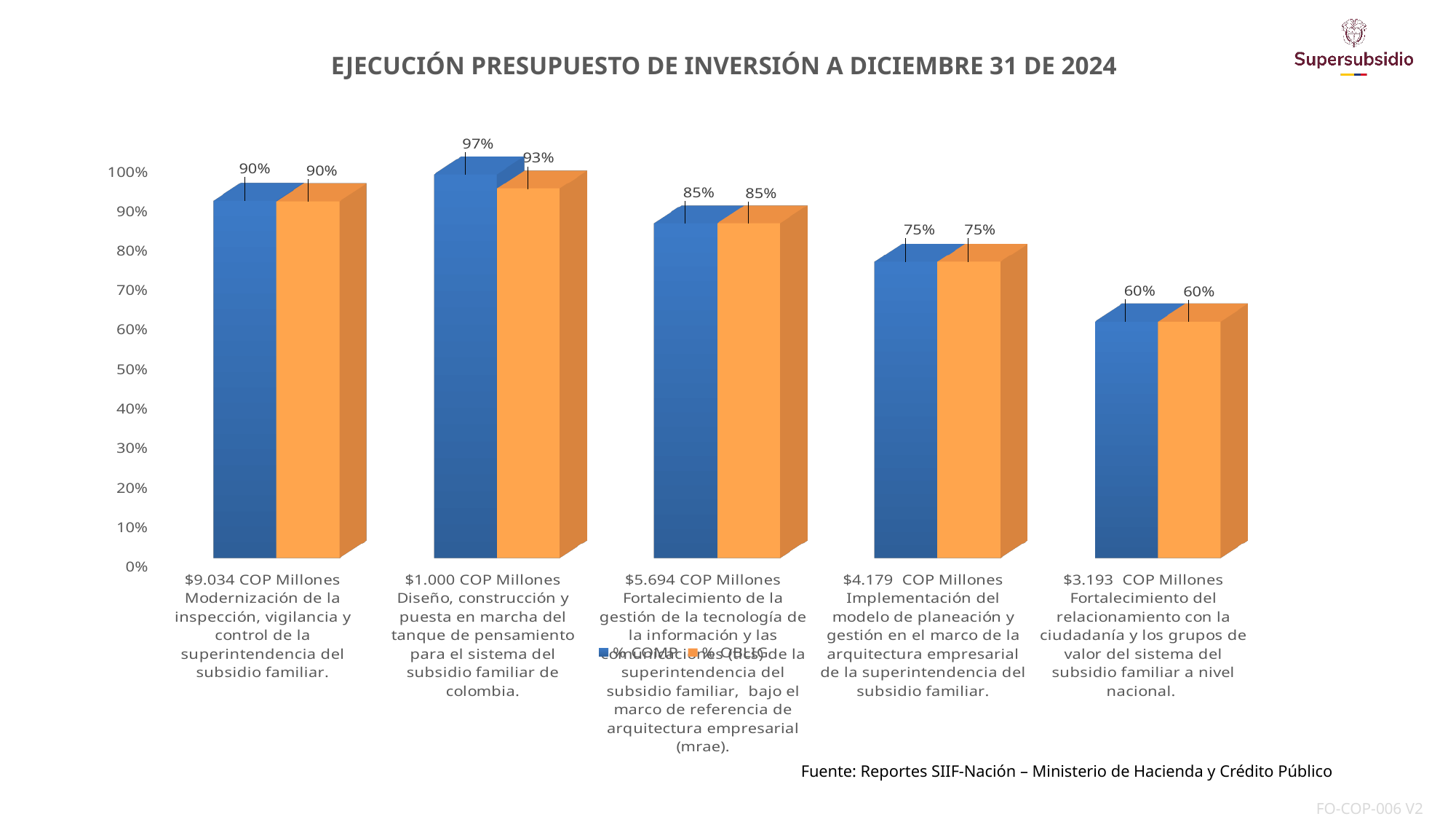
How many series does the legend list? 2 What is the difference between the % COMP and % OBLIG values for the $1.000 COP Millones project? 4% How many projects (categories) are shown on the chart? 5 What kind of chart is shown on the slide? Bar chart Which is larger: the % COMP value for the $9.034 COP Millones project or the % COMP value for the $4.179 COP Millones project? $9.034 COP Millones project What is the % OBLIG value for the $5.694 COP Millones project (Fortalecimiento de la gestión de la tecnología de la información)? 85% Which project has the lowest % OBLIG value? $3.193 COP Millones Fortalecimiento del relacionamiento con la ciudadanía y los grupos de valor del sistema del subsidio familiar a nivel nacional. What is the % COMP value for the $1.000 COP Millones project (Diseño, construcción y puesta en marcha del tanque de pensamiento)? 97% What is the title of the chart? EJECUCIÓN PRESUPUESTO DE INVERSIÓN A DICIEMBRE 31 DE 2024 Which project has the highest % COMP value? $1.000 COP Millones Diseño, construcción y puesta en marcha del tanque de pensamiento para el sistema del subsidio familiar de colombia. What is the % COMP value for the $3.193 COP Millones project (Fortalecimiento del relacionamiento con la ciudadanía)? 60% What is the % OBLIG value for the $1.000 COP Millones project (Diseño, construcción y puesta en marcha del tanque de pensamiento)? 93%